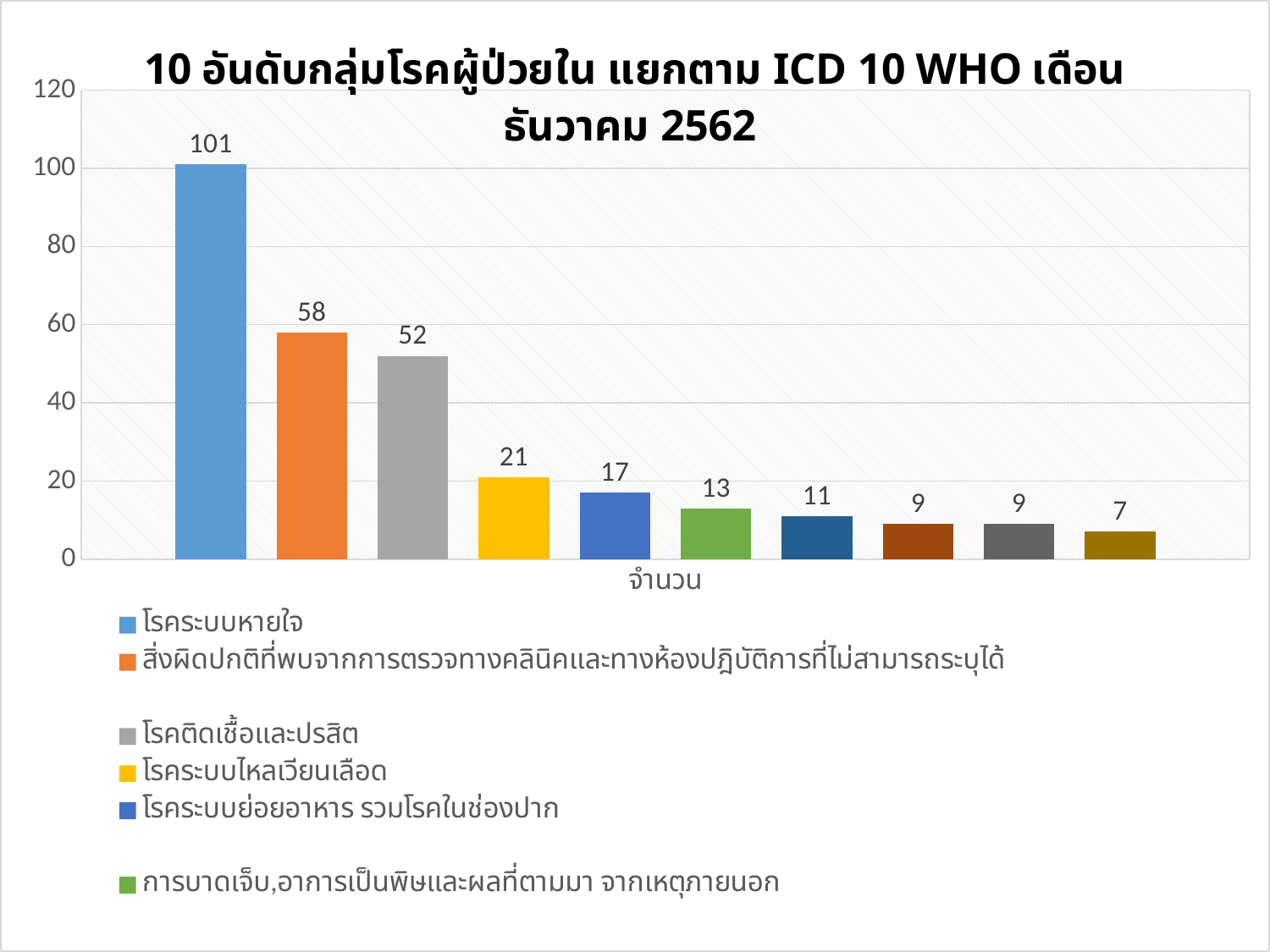
Do the bar values rise or fall from left to right along the x axis? fall How many bars are plotted in the chart? 10 What is the value of the lowest bar in the chart? 7 What is the value for โรคติดเชื้อและปรสิต? 52 What is the value for โรคระบบย่อยอาหาร รวมโรคในช่องปาก? 17 What type of chart is shown on the slide? bar chart Which is larger, the value for โรคติดเชื้อและปรสิต or the value for โรคระบบไหลเวียนเลือด? โรคติดเชื้อและปรสิต What is the value for โรคระบบหายใจ? 101 What is the difference between the values for โรคระบบหายใจ and สิ่งผิดปกติที่พบจากการตรวจทางคลินิคและทางห้องปฏิบัติการที่ไม่สามารถระบุได้? 43 Which category has the highest value? โรคระบบหายใจ What is the value for โรคระบบไหลเวียนเลือด? 21 What is the value for การบาดเจ็บ,อาการเป็นพิษและผลที่ตามมา จากเหตุภายนอก? 13